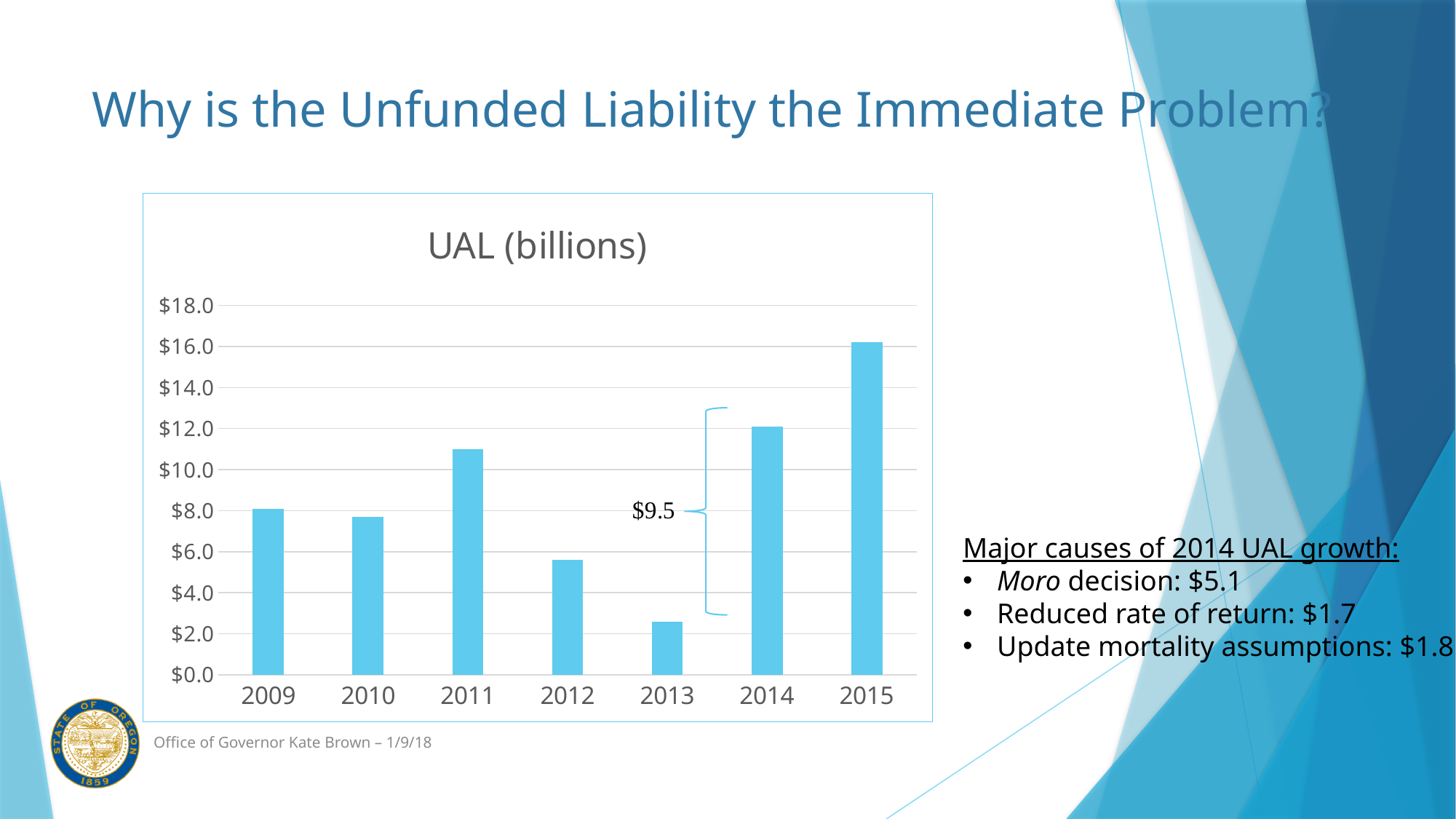
Which year has the lowest UAL value in the chart? 2013 Which year has the highest UAL value in the chart? 2015 Is the UAL value for 2012 greater or less than $6.0? less What type of chart is shown on the slide? bar chart Which year has a larger UAL value, 2011 or 2010? 2011 Is the UAL value for 2013 greater or less than $4.0? less Is the UAL value for 2015 greater or less than $14.0? greater How many years are shown on the x axis of the chart? 7 Do the UAL values rise or fall from 2011 to 2013? fall What is the title of the chart? UAL (billions) What value is printed next to the bracket between the 2013 and 2014 bars? $9.5